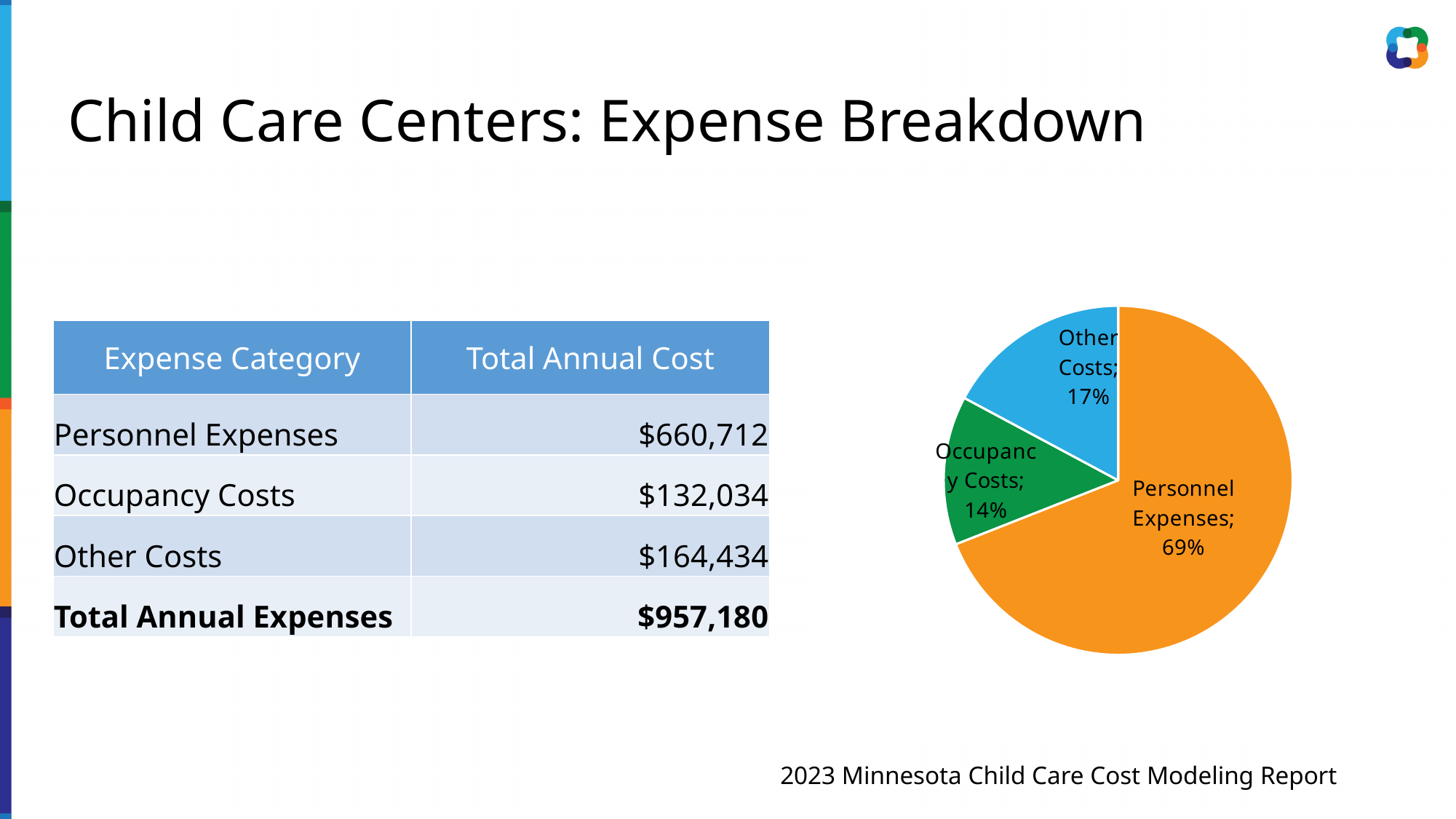
What colour is the Personnel Expenses slice in the pie chart? Orange What share of the pie chart is Personnel Expenses? 69% Which slice is larger in the pie chart, Other Costs or Occupancy Costs? Other Costs How many slices does the pie chart have? 3 Which category has the largest slice in the pie chart? Personnel Expenses Which category has the smallest slice in the pie chart? Occupancy Costs What kind of chart is shown on the slide? Pie chart What is the difference in percentage points between the Other Costs slice and the Occupancy Costs slice? 3 percentage points What share of the pie chart is Other Costs? 17% What colour is the Occupancy Costs slice in the pie chart? Green What share of the pie chart is Occupancy Costs? 14% What is the difference in percentage points between the Personnel Expenses slice and the Other Costs slice? 52 percentage points